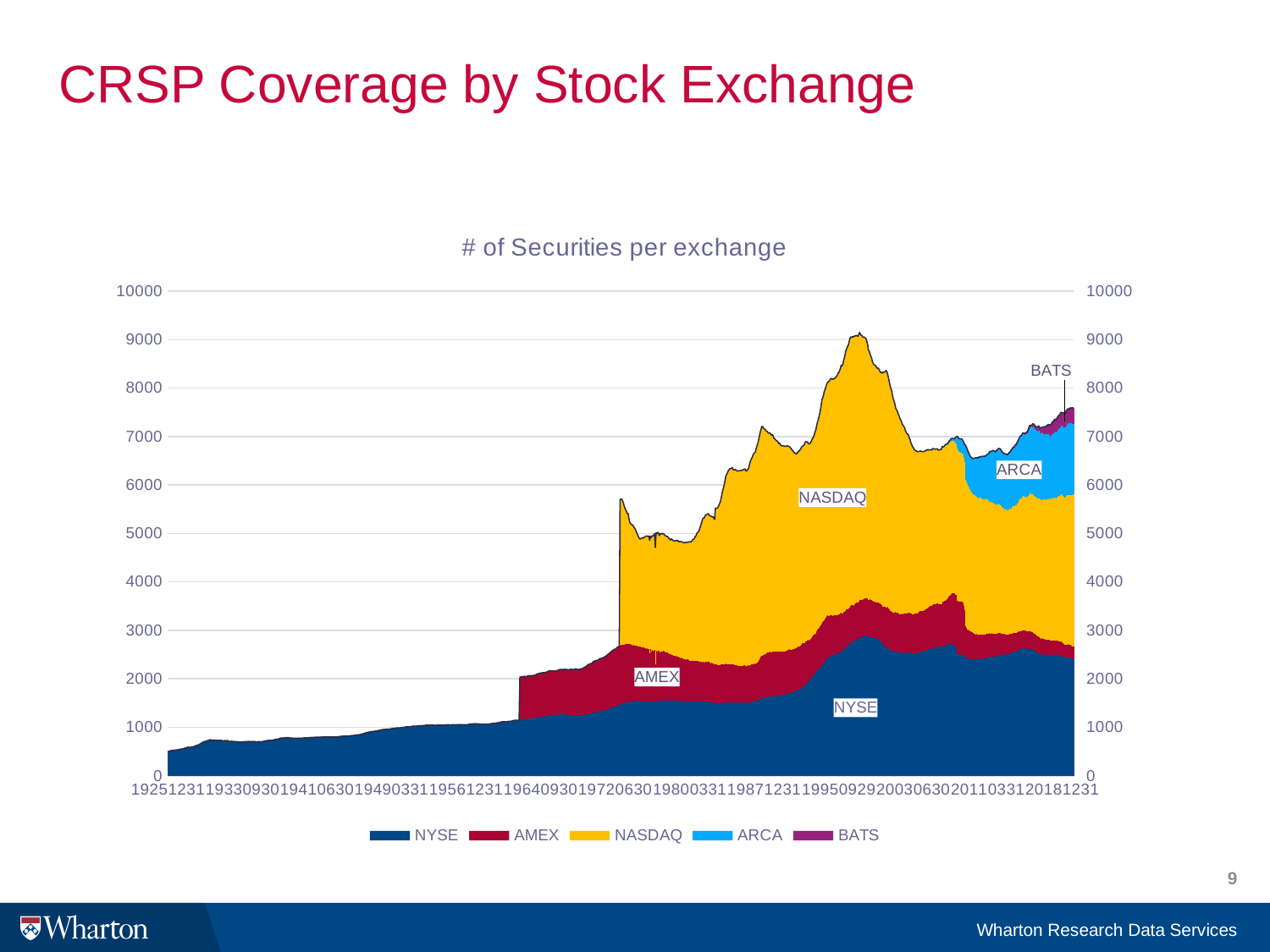
What kind of chart is shown on the slide? stacked area chart Is the total number of securities in 1925 greater or less than 1000? less Is the number of NYSE securities at the right end of the chart (2018) greater or less than 3000? less Which exchange is the last to appear in the chart, near the right edge? BATS Which is larger at the right end of the chart, the NASDAQ band or the ARCA band? NASDAQ Is the total number of securities at the right end of the chart (2018) greater or less than 7000? greater What is the maximum value shown on the vertical axis? 10000 Does the number of NYSE securities rise or fall between 1925 and 1972? rise How many series does the legend list? 5 What is the title of the chart? # of Securities per exchange Which exchange contributes the largest number of securities around the year 2000? NASDAQ Which series is plotted at the bottom of the stack? NYSE